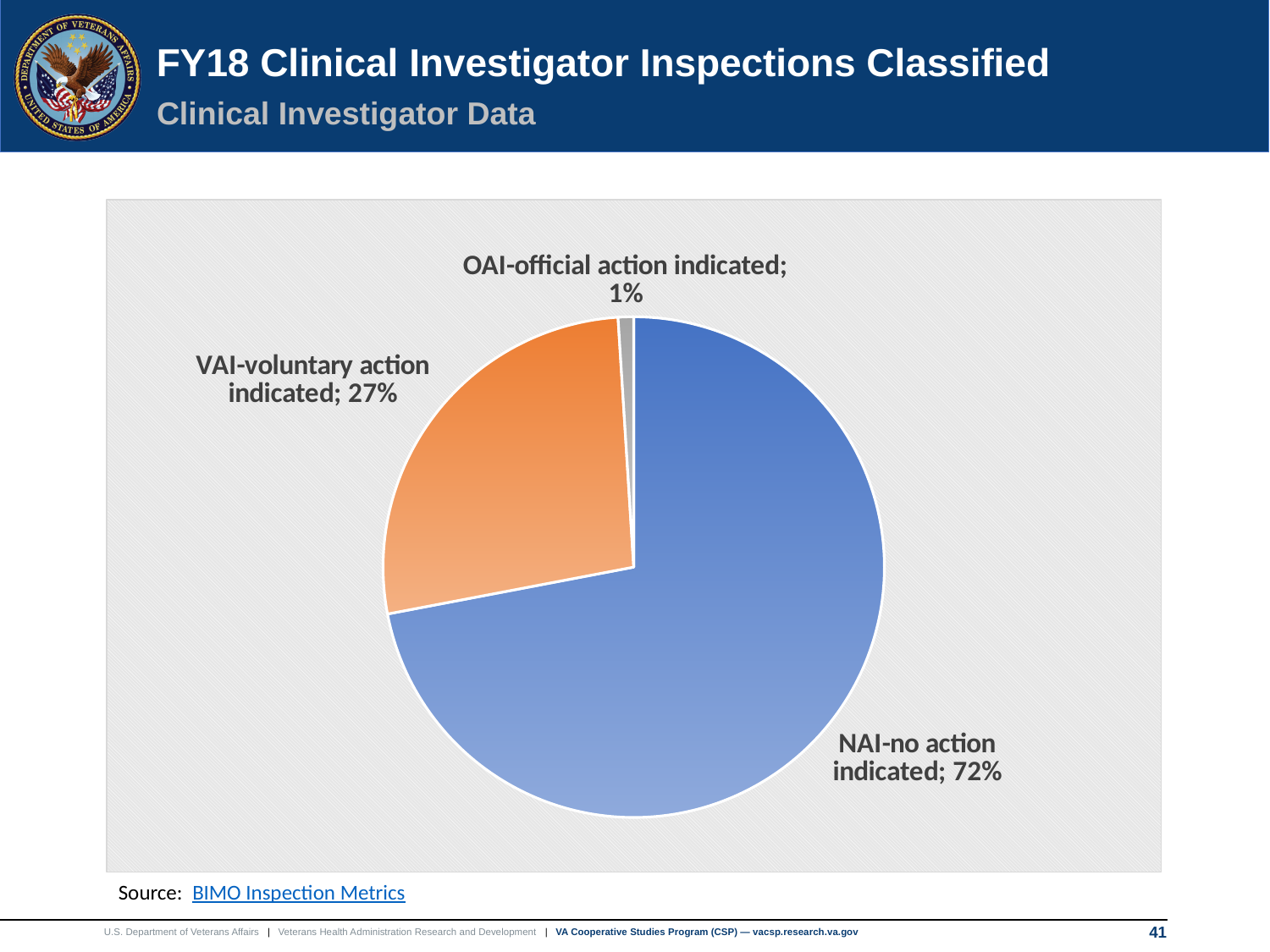
What share of FY18 clinical investigator inspections were classified as NAI-no action indicated? 72% Which is larger, the VAI-voluntary action indicated share or the OAI-official action indicated share? VAI-voluntary action indicated What colour is the VAI-voluntary action indicated slice? orange What share of inspections were classified as VAI-voluntary action indicated? 27% What is the difference in percentage points between the NAI and VAI shares? 45 What kind of chart is shown on the slide? pie chart What colour is the NAI-no action indicated slice? blue How many slices does the pie chart have? 3 Which classification has the smallest share of the pie? OAI-official action indicated What is the difference in percentage points between the VAI and OAI shares? 26 Which classification has the largest share of the pie? NAI-no action indicated What share of inspections were classified as OAI-official action indicated? 1%